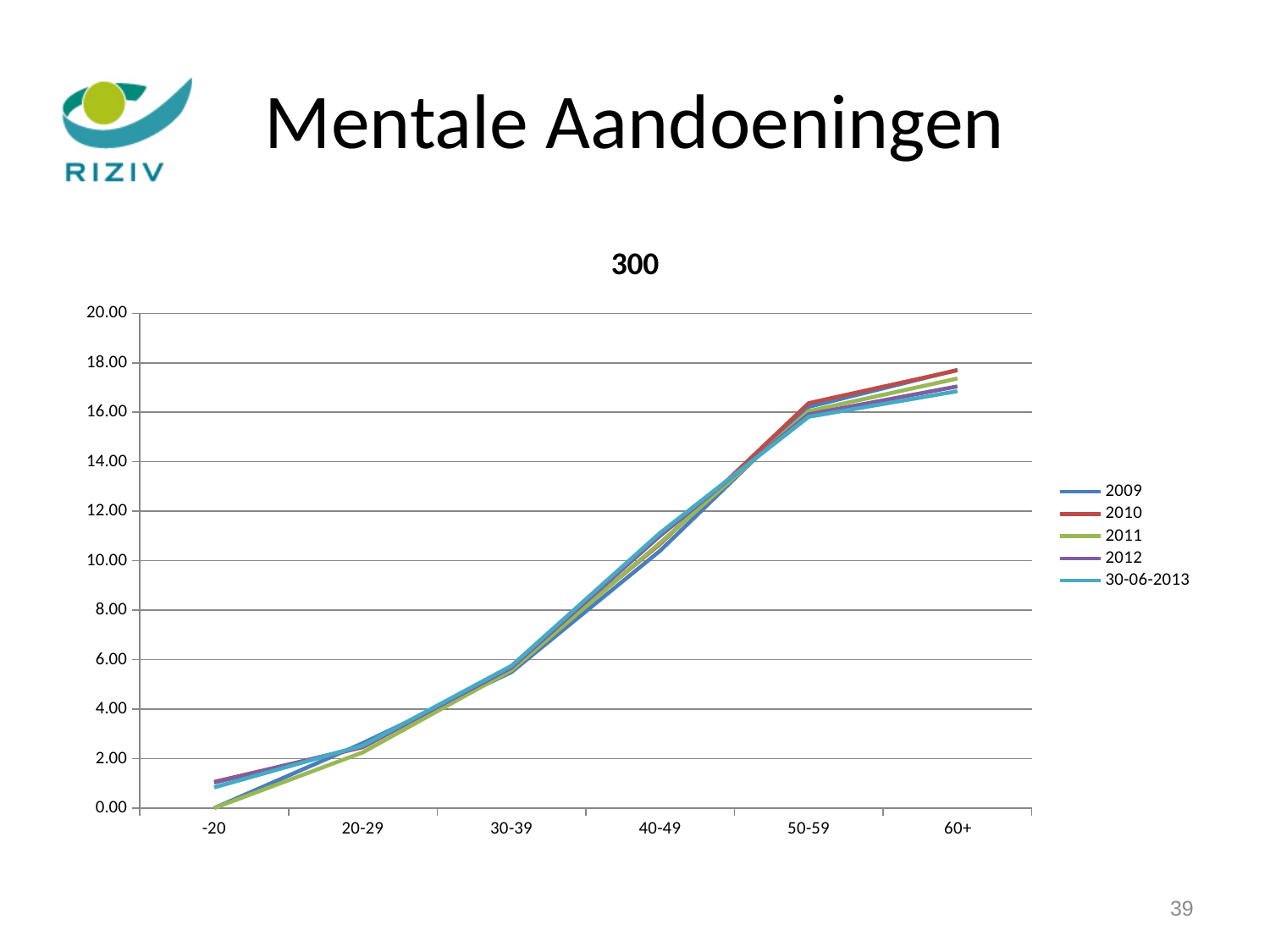
How many age categories are shown on the x axis? 6 Which age category has the highest value for the 2010 series? 60+ For the 2010 series, which is larger: the value at 60+ or the value at -20? 60+ What kind of chart is shown on the slide? line chart Which age category has the lowest value for the 2009 series? -20 Which series is listed last in the legend? 30-06-2013 Is the value for 2010 at 60+ greater or less than 16.00? greater Is the value for 2009 at 20-29 greater or less than 4.00? less Is the value for 2011 at 50-59 greater or less than 14.00? greater What is the title of the chart? 300 How many series does the legend list? 5 Do the values rise or fall along the x axis from -20 to 60+? rise